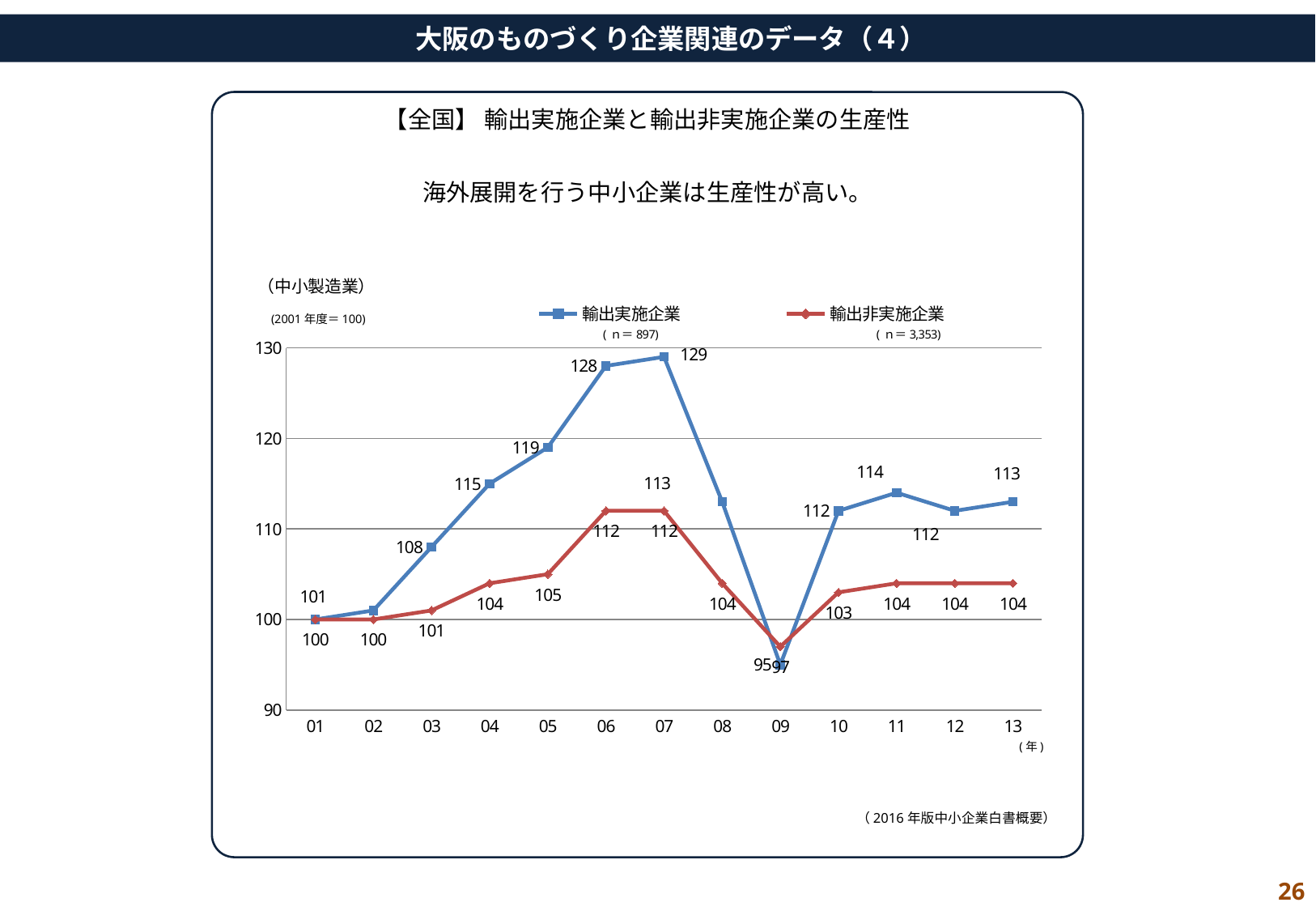
What is the value for 輸出非実施企業 in 13? 104 What is the value for 輸出実施企業 in 06? 128 How many series does the legend list? 2 In which year does 輸出実施企業 reach its highest value? 07 In which year does 輸出実施企業 reach its lowest value? 09 What is the sample size (n) shown in the legend for 輸出実施企業? 897 What is the difference between 輸出実施企業 and 輸出非実施企業 in 07? 17 How many years are plotted along the x axis? 13 What kind of chart is shown on the slide? line chart Does the value for 輸出実施企業 rise or fall from 03 to 07? rise In 11, which series has the higher value, 輸出実施企業 or 輸出非実施企業? 輸出実施企業 What is the value for 輸出実施企業 in 07? 129